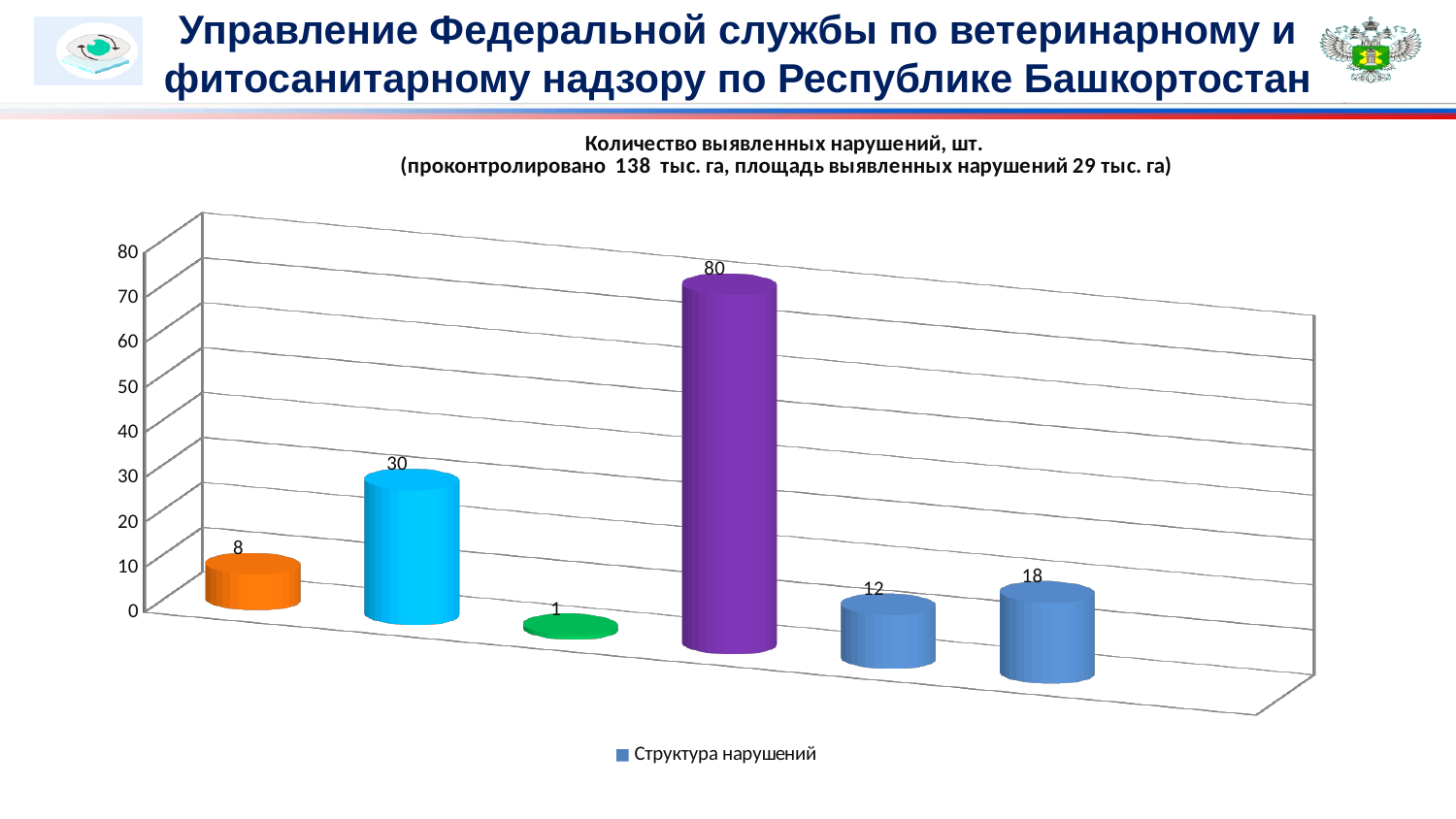
How many bars are plotted in the chart? 6 How many series does the legend list? 1 What is the difference between the purple bar (80) and the cyan bar (30)? 50 What is the legend entry of the chart? Структура нарушений What is the value of the tallest bar in the chart? 80 Which is larger: the fifth bar from the left or the sixth bar from the left? the sixth bar (18) What is the value shown on the first (orange) bar from the left? 8 What is the value shown on the last (rightmost) bar? 18 What is the value of the shortest bar in the chart? 1 What is the value shown on the second (cyan) bar from the left? 30 What is the value shown on the purple bar? 80 What kind of chart is shown on the slide? bar chart